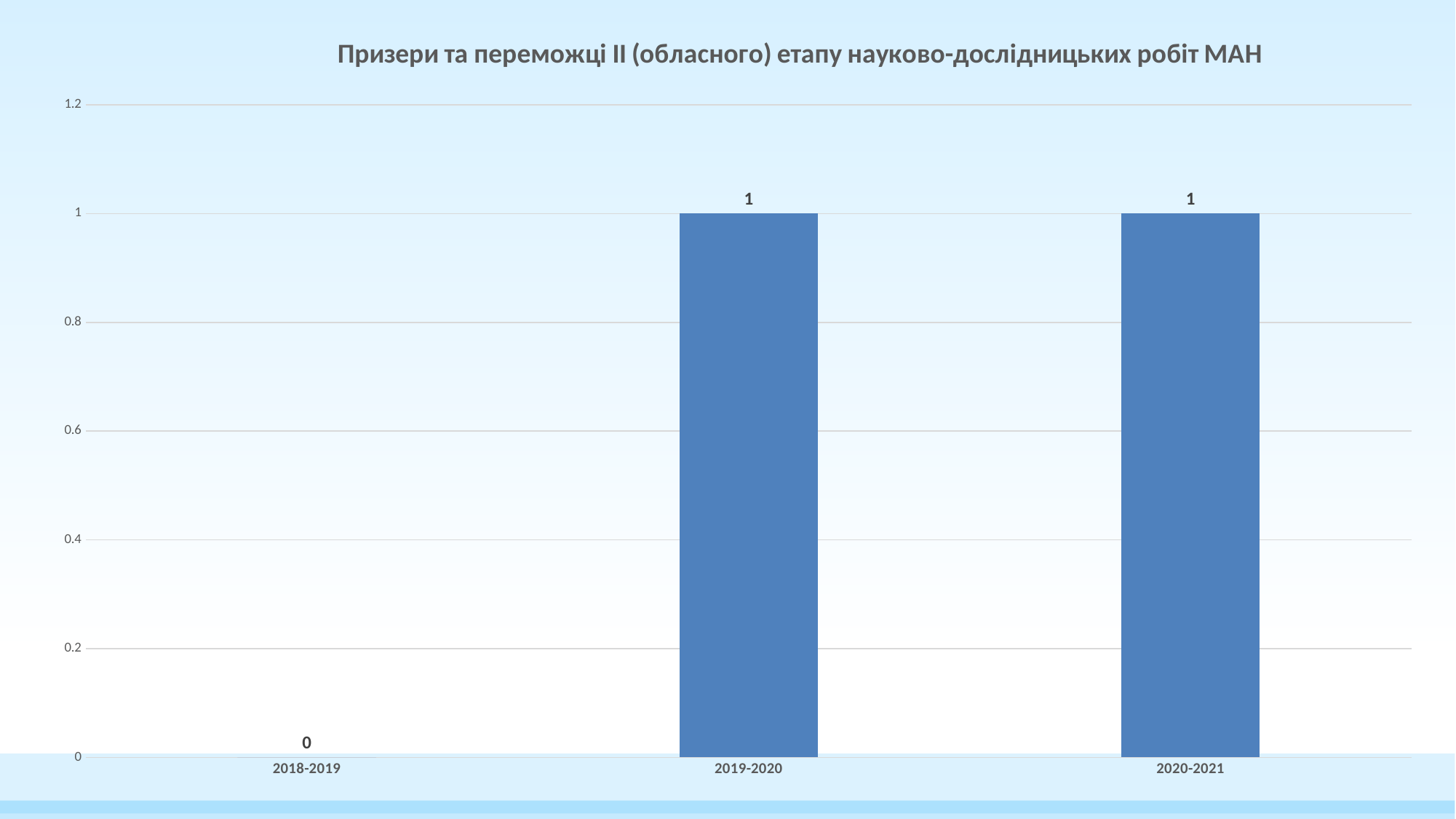
Is the value for 2018-2019 greater or less than 0.2? less Do the values rise or fall from 2018-2019 to 2019-2020? rise Which category has the lowest value? 2018-2019 What is the value for 2018-2019? 0 What is the value for 2020-2021? 1 What kind of chart is shown on the slide? bar chart What is the title of the chart? Призери та переможці ІІ (обласного) етапу науково-дослідницьких робіт МАН Is the value for 2019-2020 greater or less than 0.8? greater How many categories are shown on the x axis? 3 Which is larger, the value for 2018-2019 or the value for 2020-2021? 2020-2021 What is the value for 2019-2020? 1 What is the difference between the values for 2019-2020 and 2018-2019? 1